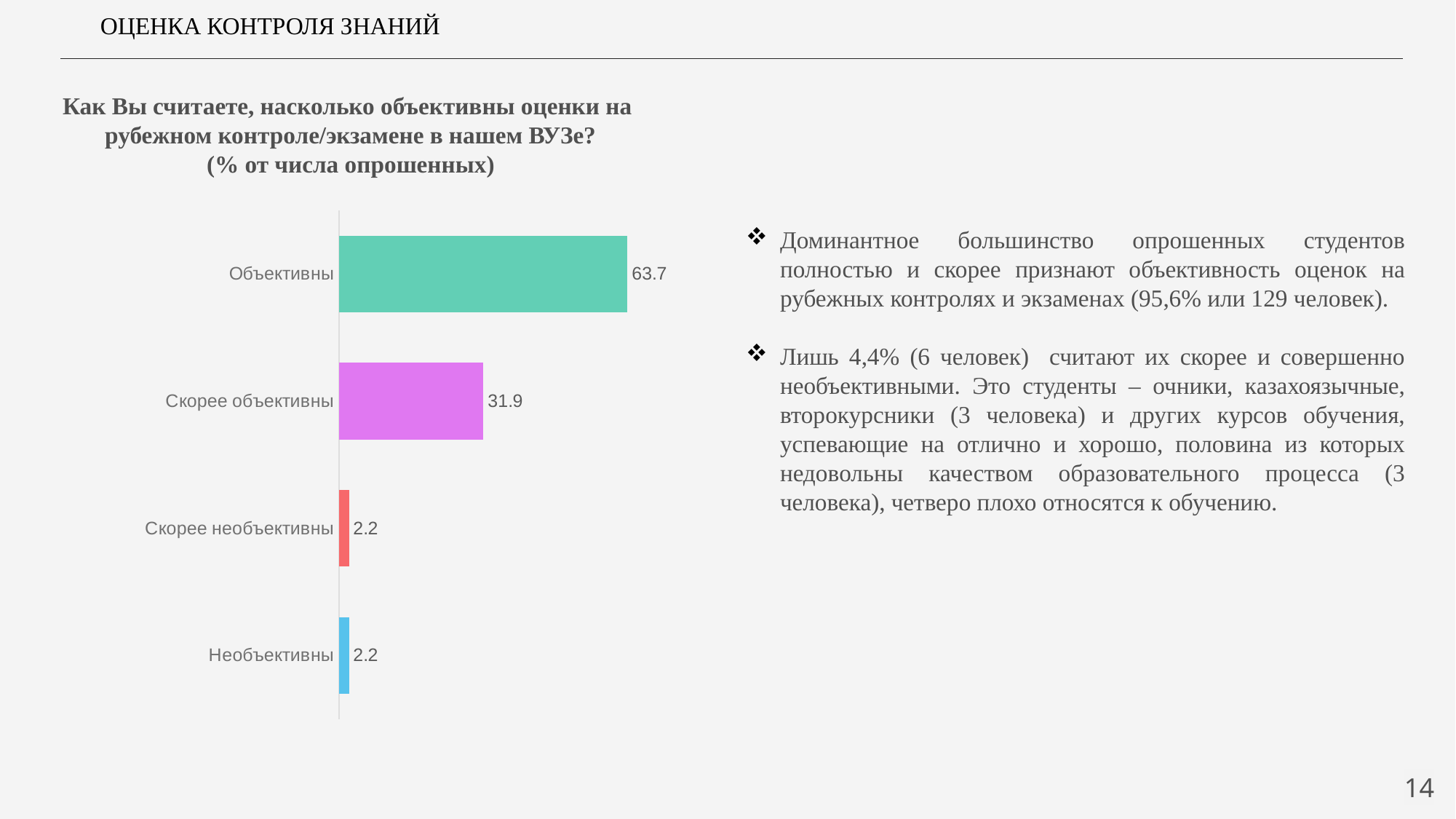
What is the combined value of Скорее необъективны and Необъективны? 4.4 What is the value for Объективны? 63.7 What is the value for Скорее объективны? 31.9 Which is larger, the value for Скорее объективны or the value for Скорее необъективны? Скорее объективны What is the value for Скорее необъективны? 2.2 What kind of chart is shown on the slide? Bar chart Which category has the highest value? Объективны How many categories are shown in the chart? 4 What colour is the bar for Объективны? Green What is the value for Необъективны? 2.2 What is the difference between the values for Объективны and Скорее объективны? 31.8 What colour is the bar for Скорее объективны? Purple